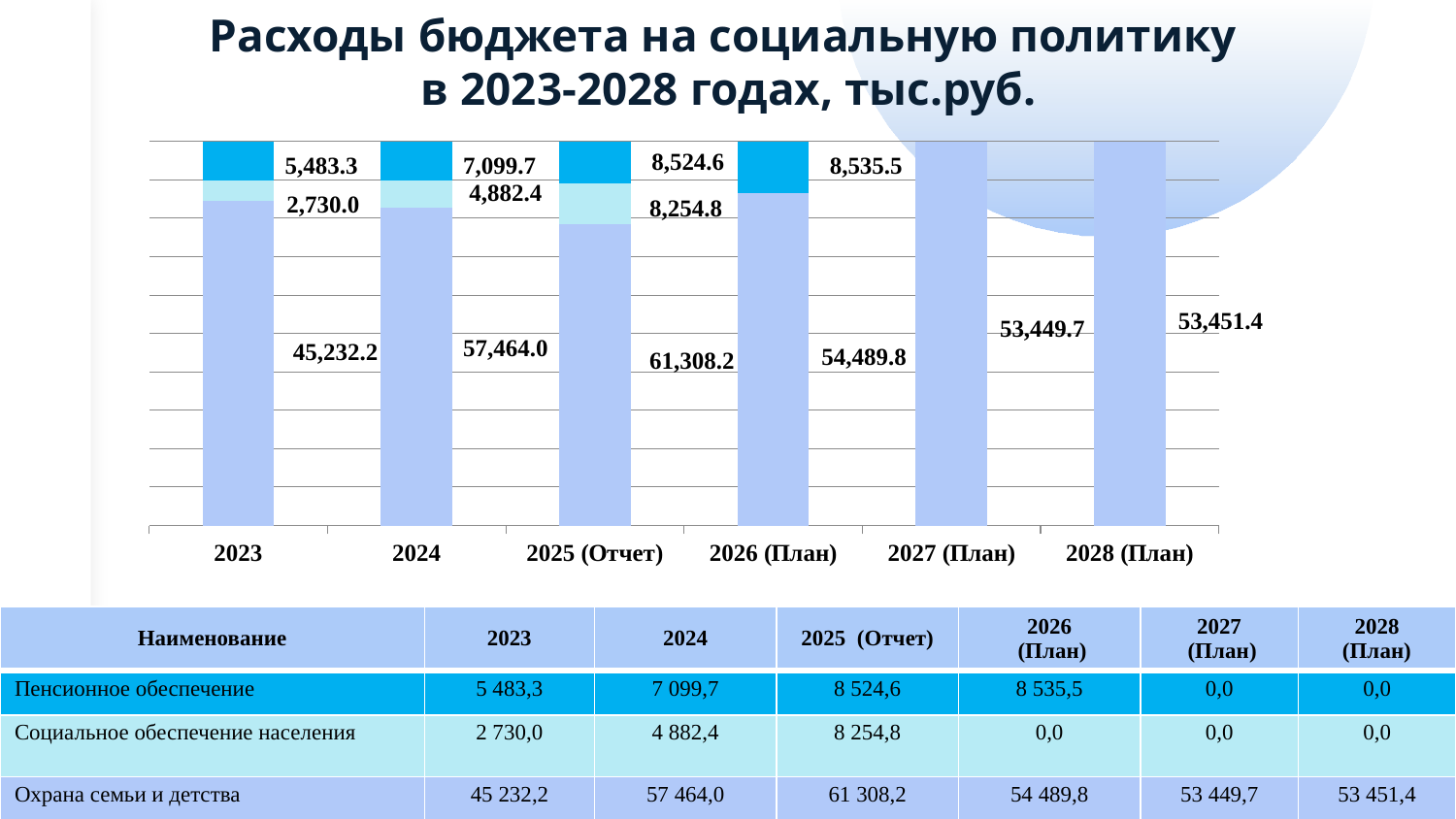
What is the value of the top (dark blue) segment for 2024 in the chart? 7,099.7 What is the value labelled on the bar for 2028 (План)? 53,451.4 Which is larger: the top (dark blue) segment for 2023 or for 2025 (Отчет)? 2025 (Отчет) What is the value of the bottom (light blue) segment for 2023 in the chart? 45,232.2 In which year is the bottom (light blue) segment the largest? 2025 (Отчет) What is the value of the middle (light cyan) segment for 2025 (Отчет) in the chart? 8,254.8 What is the total of the stacked bar for 2023? 53,445.5 In which year is the bottom (light blue) segment the smallest? 2023 What is the total of the stacked bar for 2026 (План)? 63,025.3 What kind of chart is shown on the slide? Stacked bar chart How many year categories are shown on the x axis of the chart? 6 What is the difference between the bottom segment values for 2025 (Отчет) and 2024? 3,844.2